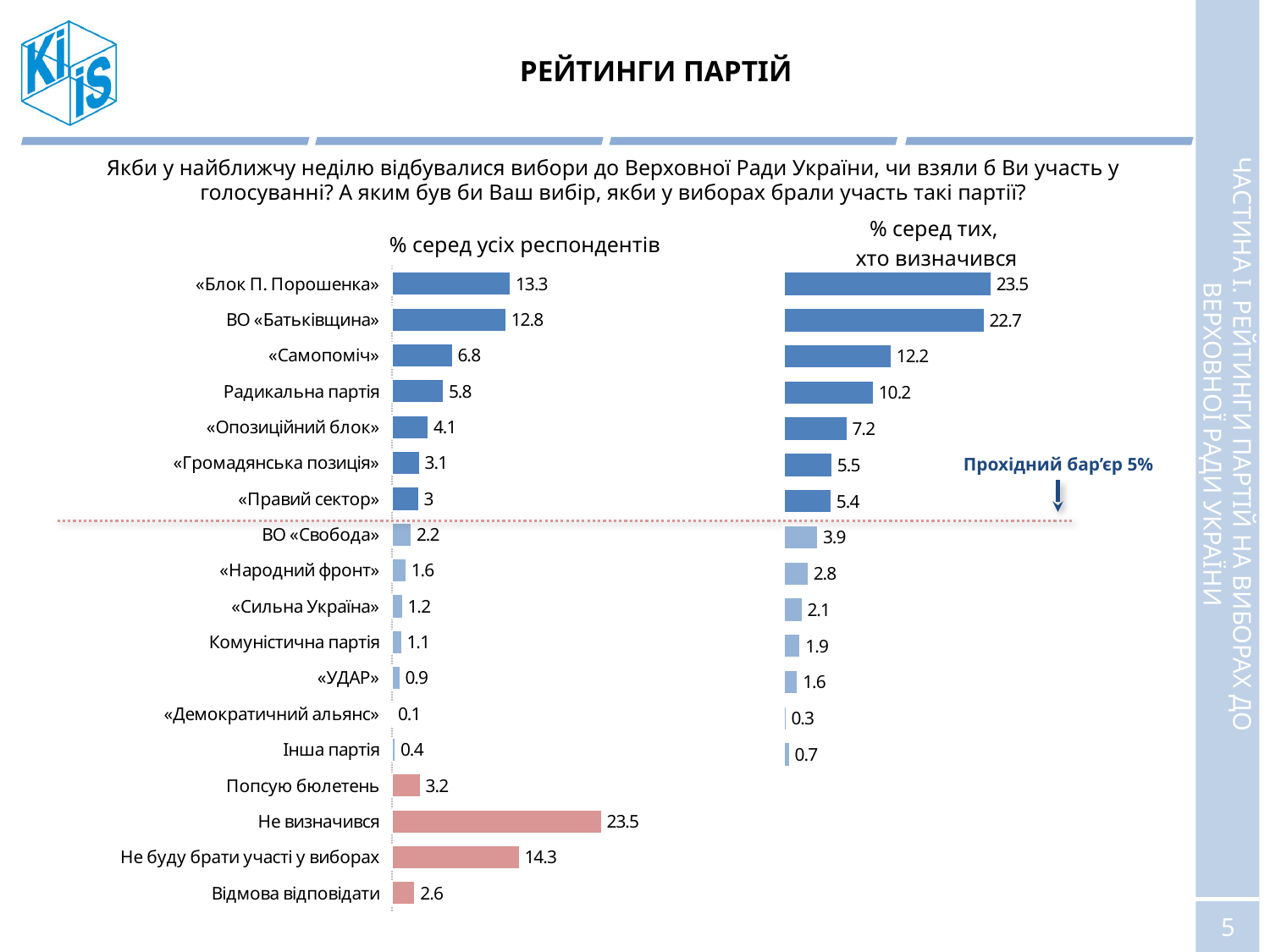
What threshold does the label next to the dotted line on the right chart indicate? Прохідний бар’єр 5% In the left chart (% серед усіх респондентів), what is the value for «Блок П. Порошенка»? 13.3 In the right chart (% серед тих, хто визначився), what is the value for ВО «Батьківщина»? 22.7 How many categories are shown in the right chart (% серед тих, хто визначився)? 14 In the left chart (% серед усіх респондентів), what is the difference between «Самопоміч» and Радикальна партія? 1 In the right chart (% серед тих, хто визначився), what is the difference between «Блок П. Порошенка» and «Самопоміч»? 11.3 In the left chart (% серед усіх респондентів), which is larger: «Опозиційний блок» or «Громадянська позиція»? «Опозиційний блок» In the right chart (% серед тих, хто визначився), which party has the lowest value? «Демократичний альянс» What type of chart is used on the slide? Bar chart In the left chart (% серед усіх респондентів), what is the value for «Не визначився»? 23.5 In the right chart (% серед тих, хто визначився), which party has the highest value? «Блок П. Порошенка» In the right chart (% серед тих, хто визначився), what is the value for «Правий сектор»? 5.4